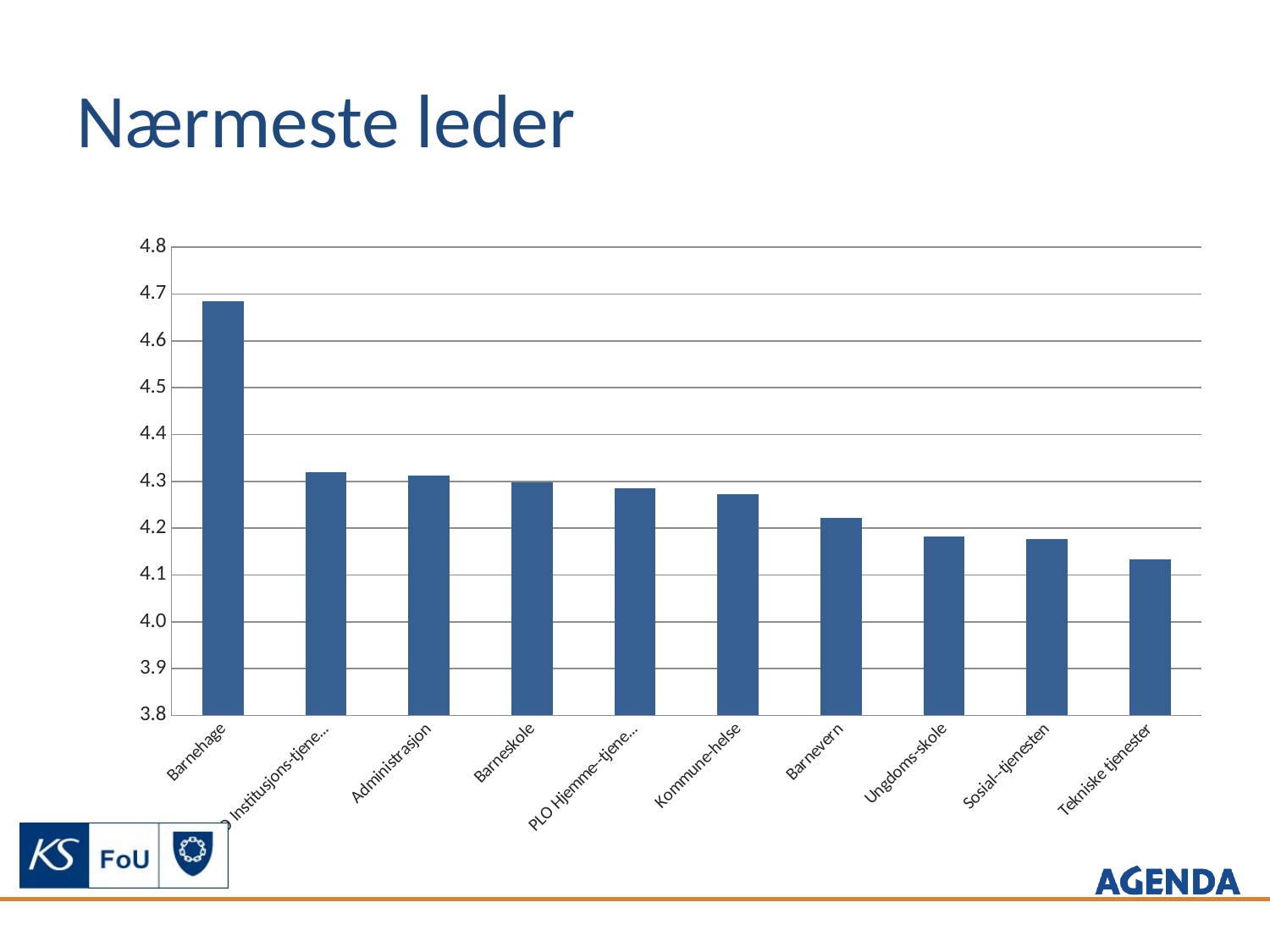
Do the values rise or fall from left to right along the x axis? fall Which is larger, the value for Barneskole or the value for Ungdoms-skole? Barneskole Which is larger, the value for Barnehage or the value for Administrasjon? Barnehage Is the value for Barnehage greater or less than 4.6? greater What kind of chart is shown on the slide? bar chart What is the title of the slide? Nærmeste leder How many bars are plotted in the chart? 10 Which category has the lowest value? Tekniske tjenester Is the value for Kommune-helse greater or less than 4.3? less Which is larger, the value for Sosial-tjenesten or the value for Kommune-helse? Kommune-helse Which category has the highest value? Barnehage Is the value for Tekniske tjenester greater or less than 4.2? less